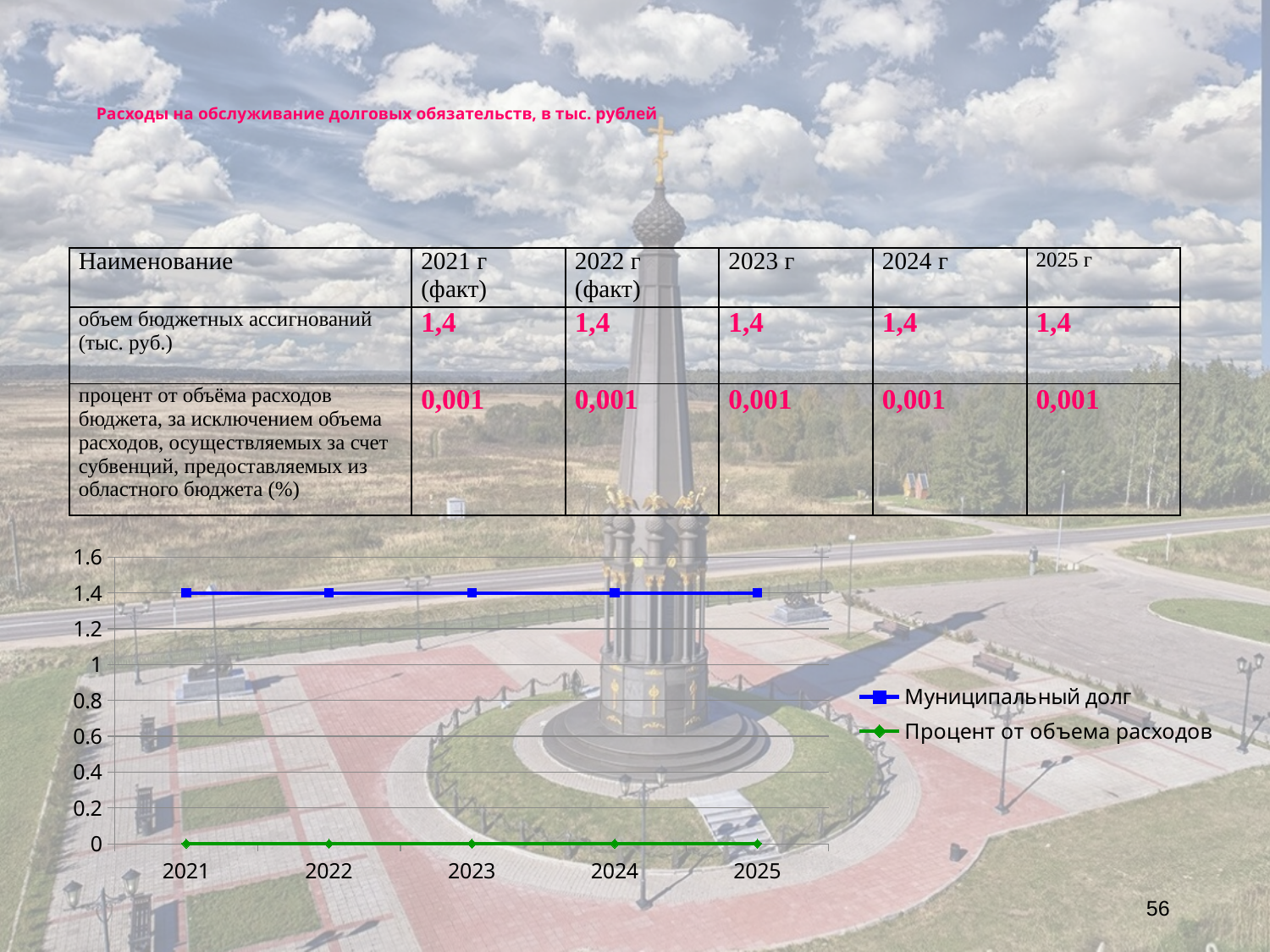
Is the value for Муниципальный долг in 2024 greater or less than 1? greater Is the value for Процент от объема расходов in 2023 greater or less than 0.2? less What is the first year shown on the x axis of the chart? 2021 What is the highest value shown on the y axis of the chart? 1.6 How many years are shown on the x axis of the chart? 5 What kind of chart is shown on the slide? line chart How many series does the chart legend list? 2 What is the value of Муниципальный долг in 2021 on the chart? 1.4 Does the Муниципальный долг line rise, fall or stay flat from 2021 to 2025? stays flat What colour is the Муниципальный долг line in the chart? blue Which series has the higher value in 2022, Муниципальный долг or Процент от объема расходов? Муниципальный долг What is the value of Муниципальный долг in 2025 on the chart? 1.4